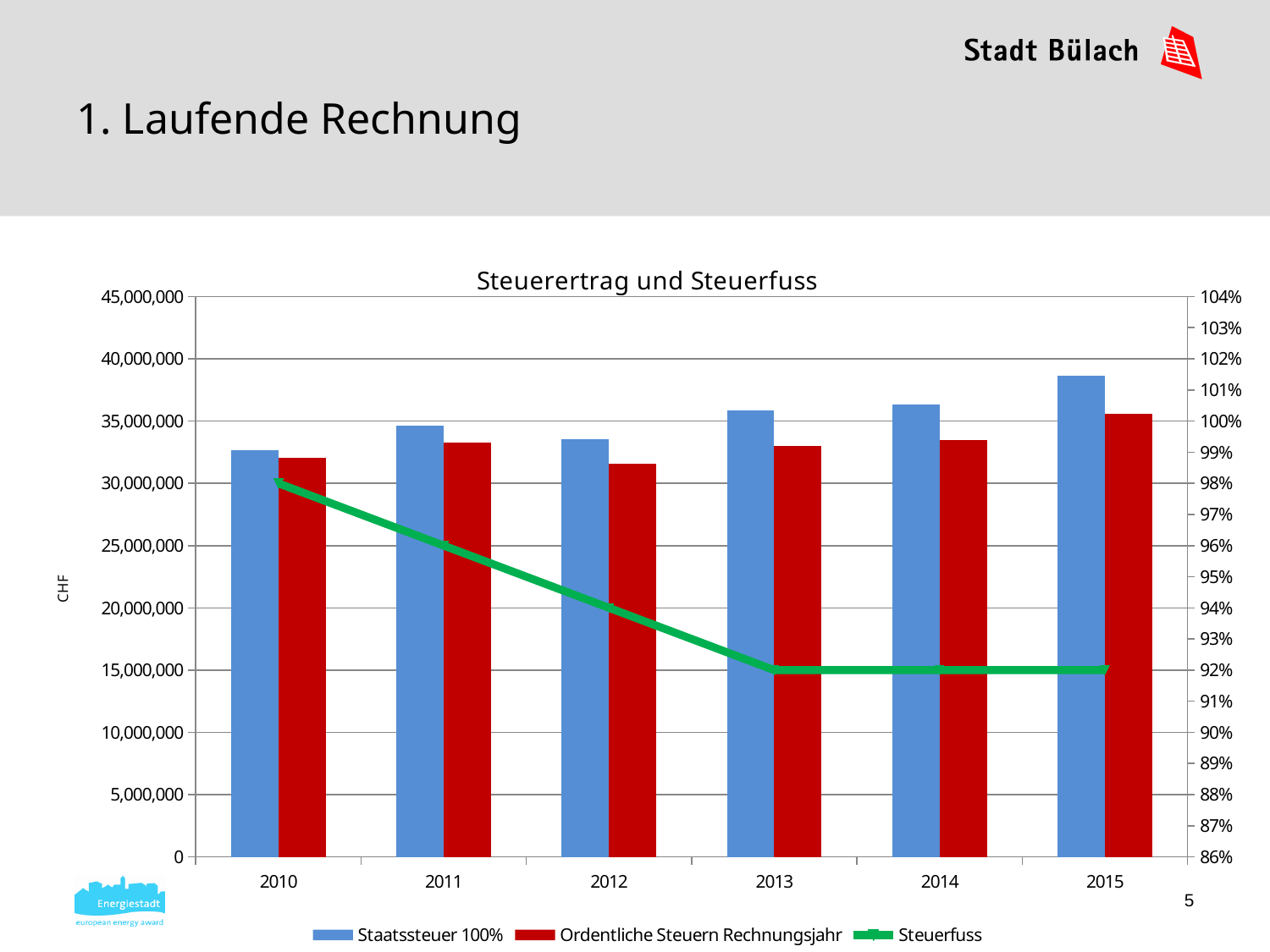
Which is larger in 2015: Staatssteuer 100% or Ordentliche Steuern Rechnungsjahr? Staatssteuer 100% In which year is the Staatssteuer 100% bar highest? 2015 What is the Steuerfuss value for 2015? 92% How many years are shown on the x axis of the chart? 6 What is the Steuerfuss value for 2013? 92% What is the title of the chart? Steuerertrag und Steuerfuss In which year is the Ordentliche Steuern Rechnungsjahr bar lowest? 2012 Does the Steuerfuss line rise or fall from 2010 to 2013? fall Is the Ordentliche Steuern Rechnungsjahr value for 2012 greater or less than 35,000,000? less What is the Steuerfuss value for 2010? 98% How many series does the chart legend list? 3 Is the Staatssteuer 100% value for 2015 greater or less than 35,000,000? greater